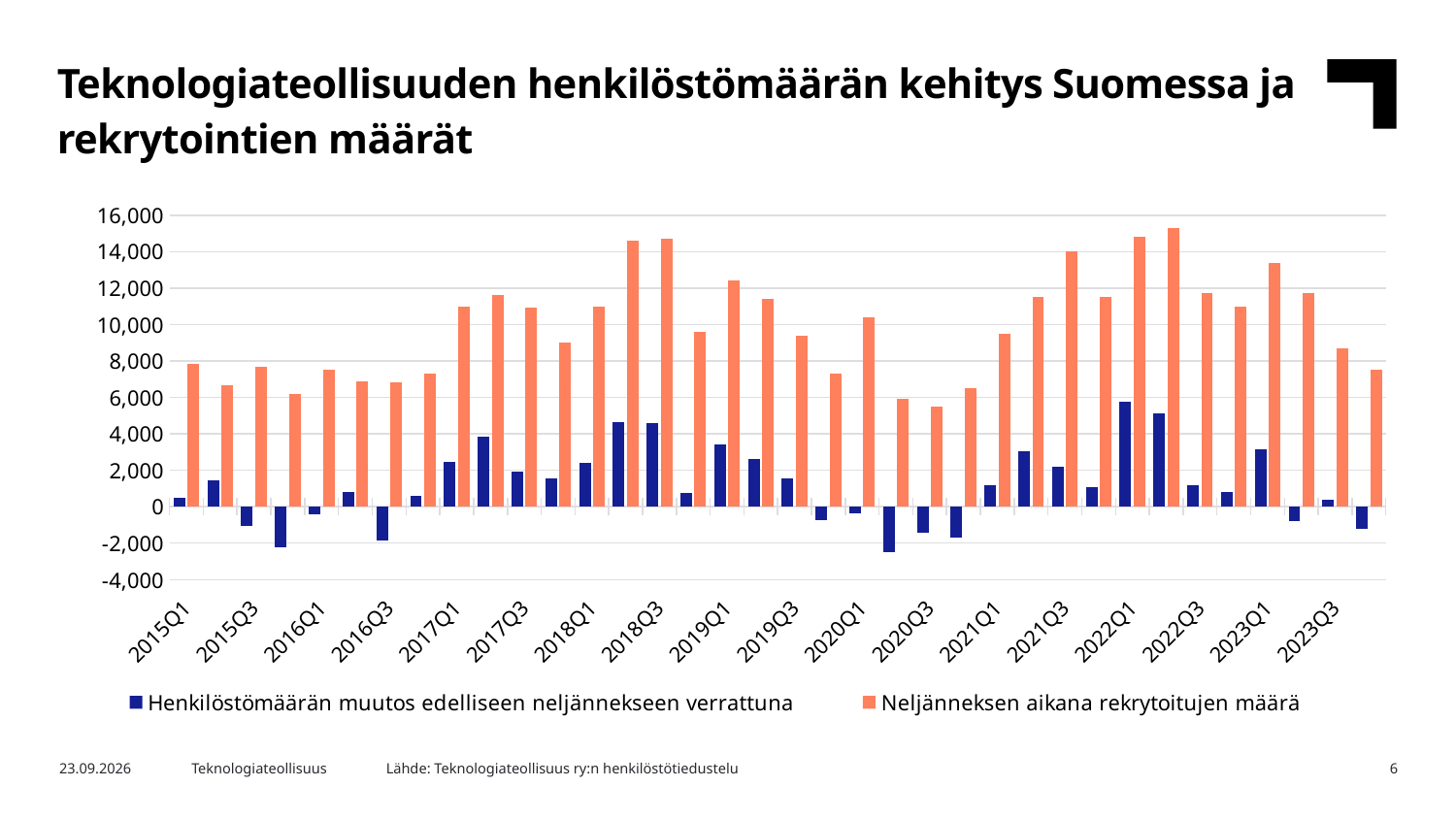
Which is larger, the Neljänneksen aikana rekrytoitujen määrä value for 2018Q3 or for 2016Q3? 2018Q3 What type of chart is shown on the slide? Bar chart Is the value of Neljänneksen aikana rekrytoitujen määrä for 2021Q3 greater or less than 12,000? greater Which series is shown in orange? Neljänneksen aikana rekrytoitujen määrä Which labeled quarter has the highest value for Henkilöstömäärän muutos edelliseen neljännekseen verrattuna? 2022Q1 Which is larger, the Henkilöstömäärän muutos edelliseen neljännekseen verrattuna value for 2022Q1 or for 2017Q1? 2022Q1 How many series does the legend list? 2 Is the value of Henkilöstömäärän muutos edelliseen neljännekseen verrattuna for 2022Q1 greater or less than 4,000? greater Which series is shown in dark blue? Henkilöstömäärän muutos edelliseen neljännekseen verrattuna Is the value of Henkilöstömäärän muutos edelliseen neljännekseen verrattuna for 2015Q3 greater or less than 0? less